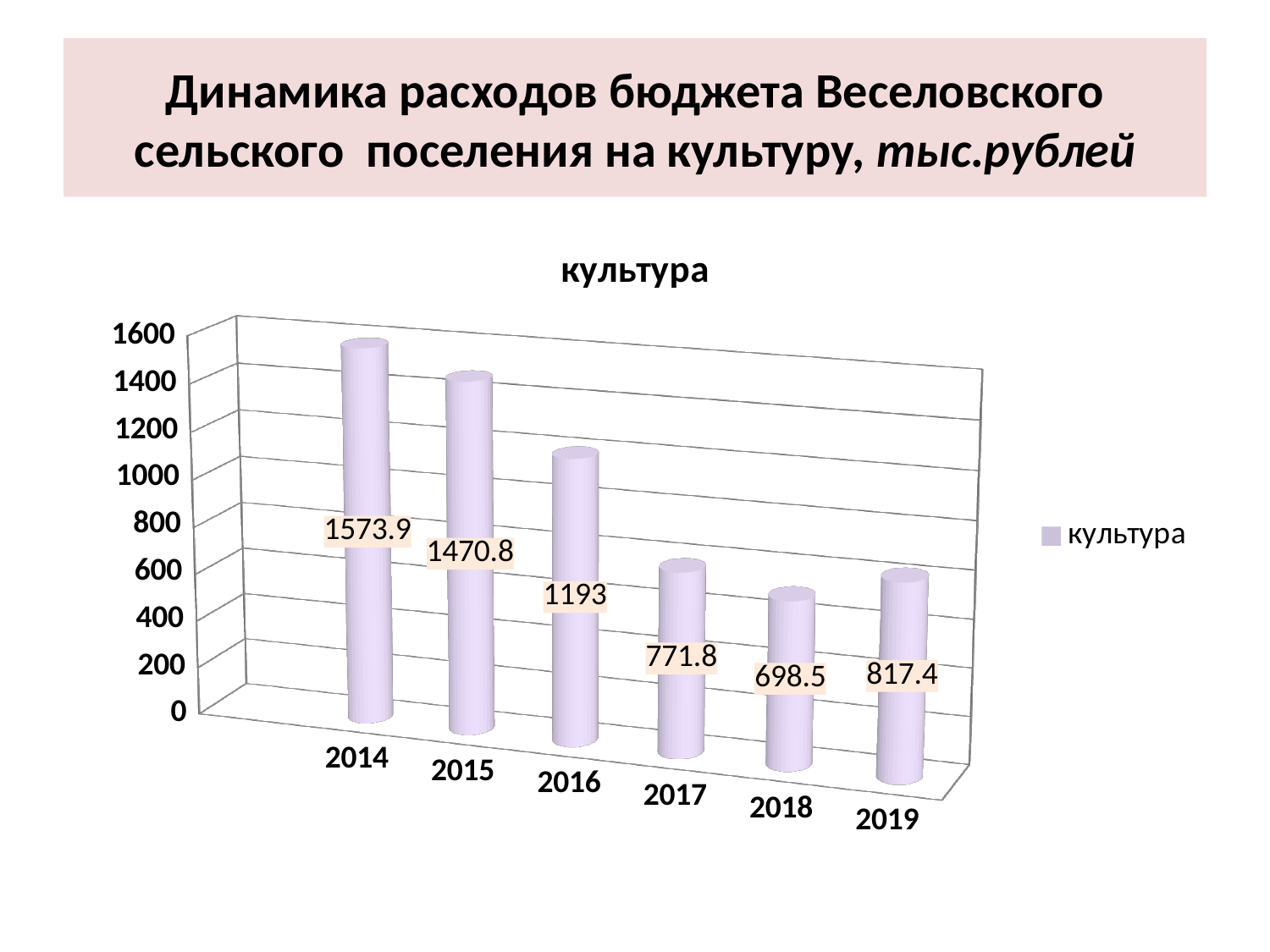
What is the difference between the values for 2019 and 2018? 118.9 Which year has the highest value? 2014 How many years are shown on the x axis? 6 What is the difference between the values for 2014 and 2015? 103.1 What is the value for 2016? 1193 Is the value for 2016 greater or less than 1000? greater Which is larger, the value for 2017 or the value for 2019? 2019 What is the value for 2014? 1573.9 What is the value for 2019? 817.4 What kind of chart is shown? bar chart Which year has the lowest value? 2018 What is the title of the chart? культура